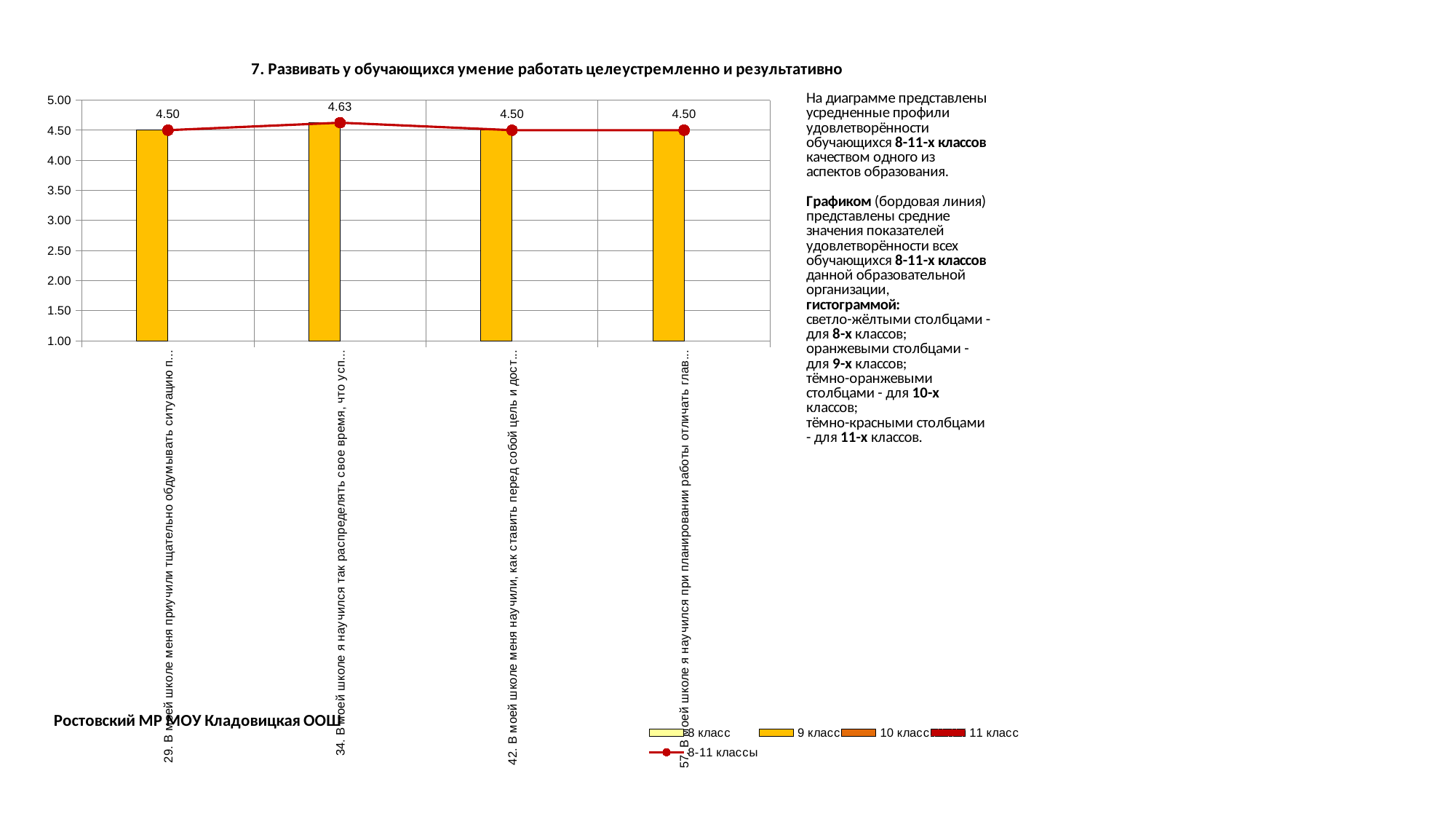
Is the value for item 29 greater or less than 4.00? greater How many series does the legend list? 5 What kind of chart is this? Bar chart with a line series Which has the larger labelled value, item 34 or item 42? 34 What value is labelled for item 57 ("В моей школе я научился при планировании работы...")? 4.50 How many items (categories) are shown on the x axis? 4 Which item has the highest labelled value? 34 What is the title of the chart? 7. Развивать у обучающихся умение работать целеустремленно и результативно Is the value for item 57 greater or less than 3.00? greater What value is labelled for item 34 ("В моей школе я научился так распределять свое время...")? 4.63 What is the difference between the labelled values for item 34 and item 29? 0.13 Which legend entry is shown as a line with markers? 8-11 классы